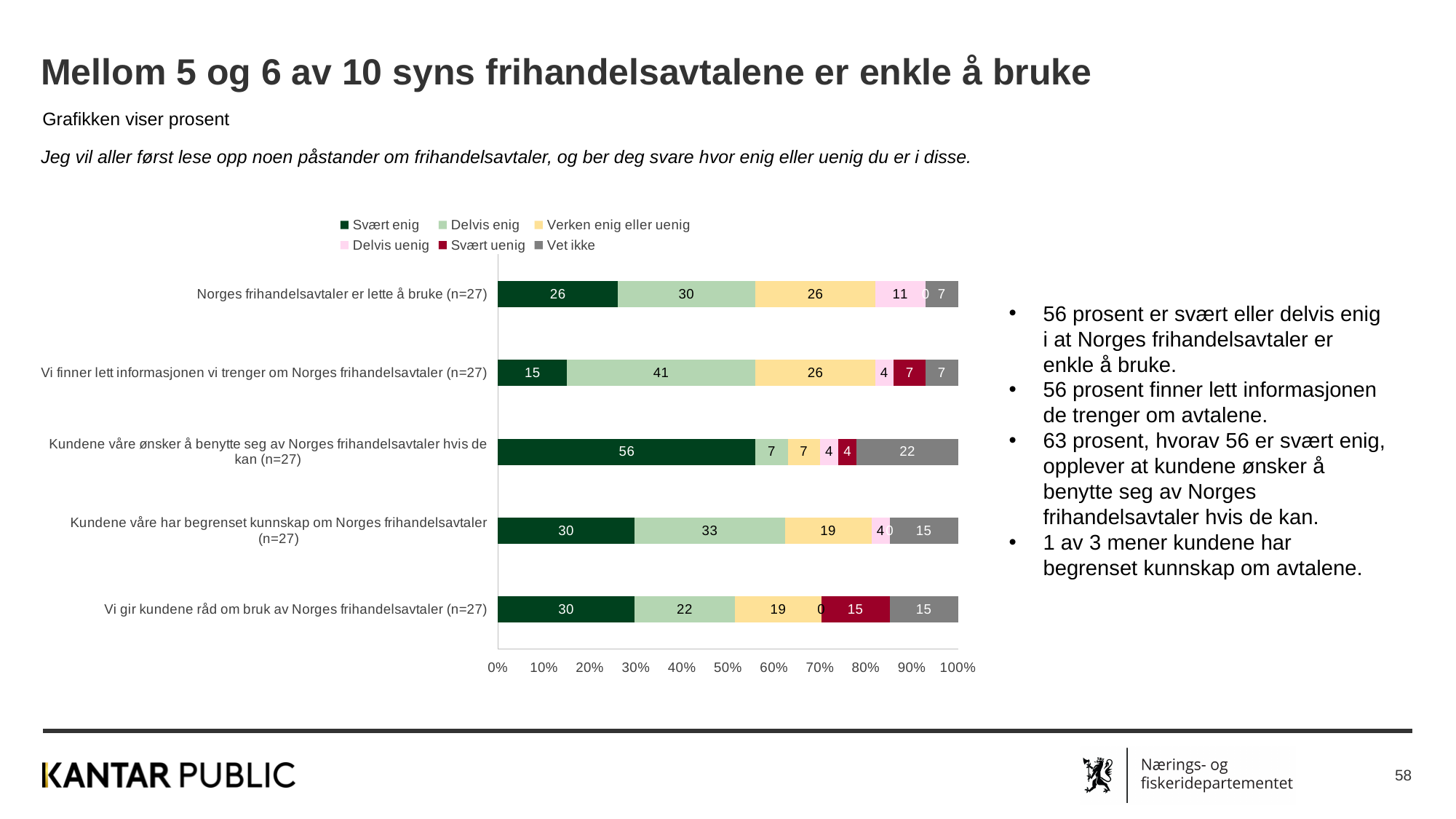
What is the 'Svært uenig' value for 'Vi gir kundene råd om bruk av Norges frihandelsavtaler (n=27)'? 15 What is the 'Vet ikke' value for 'Kundene våre ønsker å benytte seg av Norges frihandelsavtaler hvis de kan (n=27)'? 22 How many statements (categories) are shown in the chart? 5 What is the combined 'Svært enig' and 'Delvis enig' value for 'Kundene våre har begrenset kunnskap om Norges frihandelsavtaler (n=27)'? 63 What is the difference between the 'Delvis enig' values for 'Vi finner lett informasjonen vi trenger om Norges frihandelsavtaler (n=27)' and 'Vi gir kundene råd om bruk av Norges frihandelsavtaler (n=27)'? 19 What kind of chart is shown on the slide? Stacked bar chart Which statement has the lowest 'Svært enig' value? Vi finner lett informasjonen vi trenger om Norges frihandelsavtaler (n=27) What is the 'Delvis enig' value for 'Vi finner lett informasjonen vi trenger om Norges frihandelsavtaler (n=27)'? 41 How many series does the legend list? 6 What is the 'Svært enig' value for 'Kundene våre ønsker å benytte seg av Norges frihandelsavtaler hvis de kan (n=27)'? 56 Which is larger: the 'Verken enig eller uenig' value for 'Norges frihandelsavtaler er lette å bruke (n=27)' or for 'Kundene våre har begrenset kunnskap om Norges frihandelsavtaler (n=27)'? Norges frihandelsavtaler er lette å bruke (n=27) Which statement has the highest 'Svært enig' value? Kundene våre ønsker å benytte seg av Norges frihandelsavtaler hvis de kan (n=27)